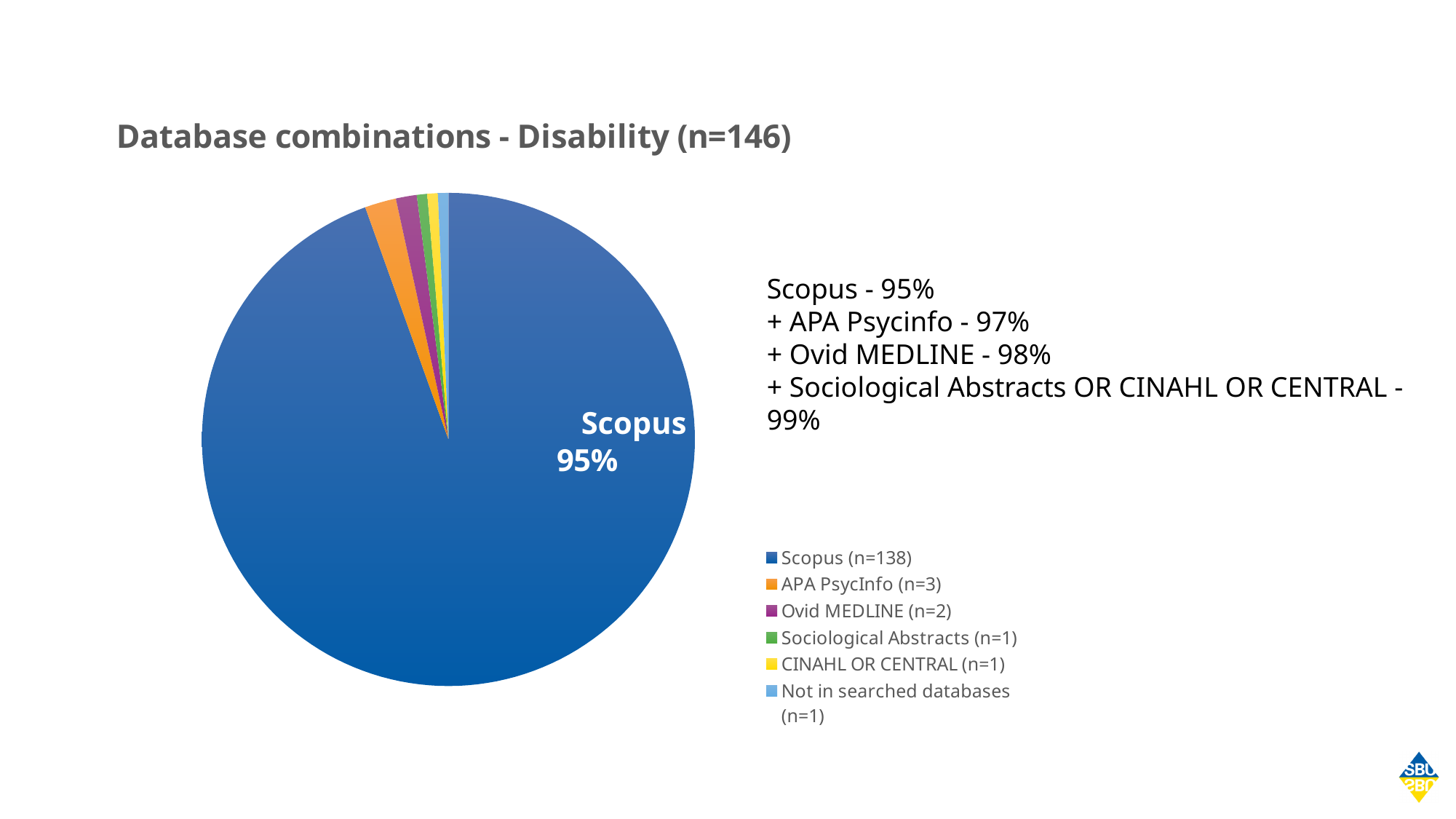
What kind of chart is shown on the slide? pie chart According to the legend, how many records are in the APA PsycInfo slice? 3 Which is larger, the APA PsycInfo slice or the Ovid MEDLINE slice? APA PsycInfo According to the legend, how many records are in the 'Not in searched databases' slice? 1 Which slice of the pie is the largest? Scopus What share of the pie does the Scopus slice represent, according to its data label? 95% Which colour is used for the Scopus slice? blue How many entries does the chart legend list? 6 According to the legend, how many records are in the Ovid MEDLINE slice? 2 According to the legend, how many records are in the Scopus slice? 138 What is the difference in record count between the Scopus slice (n=138) and the APA PsycInfo slice (n=3)? 135 What is the title of the chart? Database combinations - Disability (n=146)